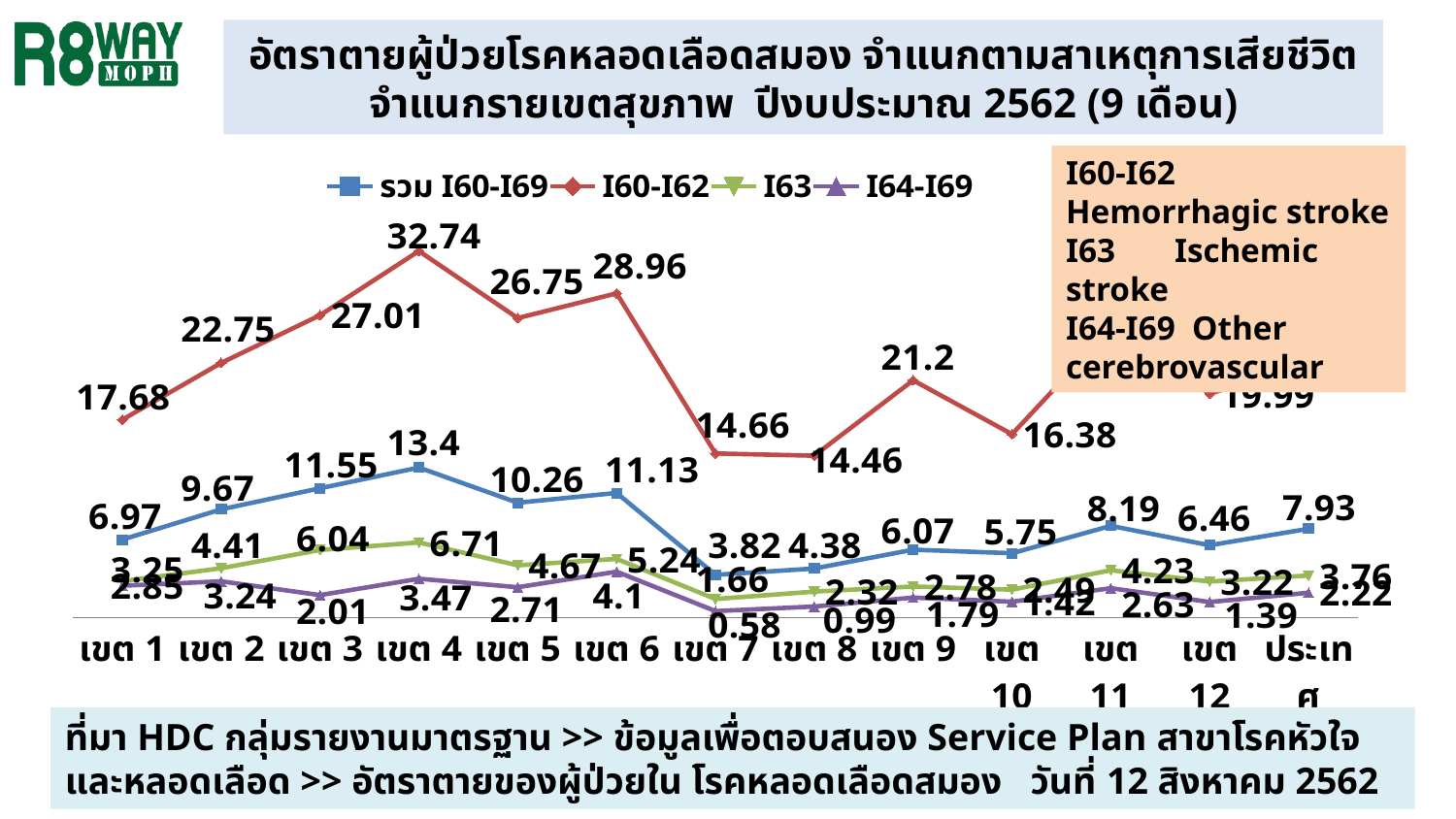
Does the รวม I60-I69 series rise or fall from เขต 1 to เขต 4? rise What is the difference between the รวม I60-I69 values for เขต 4 and เขต 7? 9.58 What is the value of the I63 series for ประเทศ? 3.76 How many series does the legend list? 4 What is the value of the I64-I69 series for เขต 6? 4.1 How many categories are shown on the x axis? 13 What kind of chart is shown on the slide? line chart For the I60-I62 series, which is larger: the value for เขต 2 or the value for เขต 5? เขต 5 What is the value of the I60-I62 series for เขต 4? 32.74 Which category has the lowest value for the I64-I69 series? เขต 7 What is the value of the รวม I60-I69 series for เขต 7? 3.82 Which category has the highest value for the รวม I60-I69 series? เขต 4